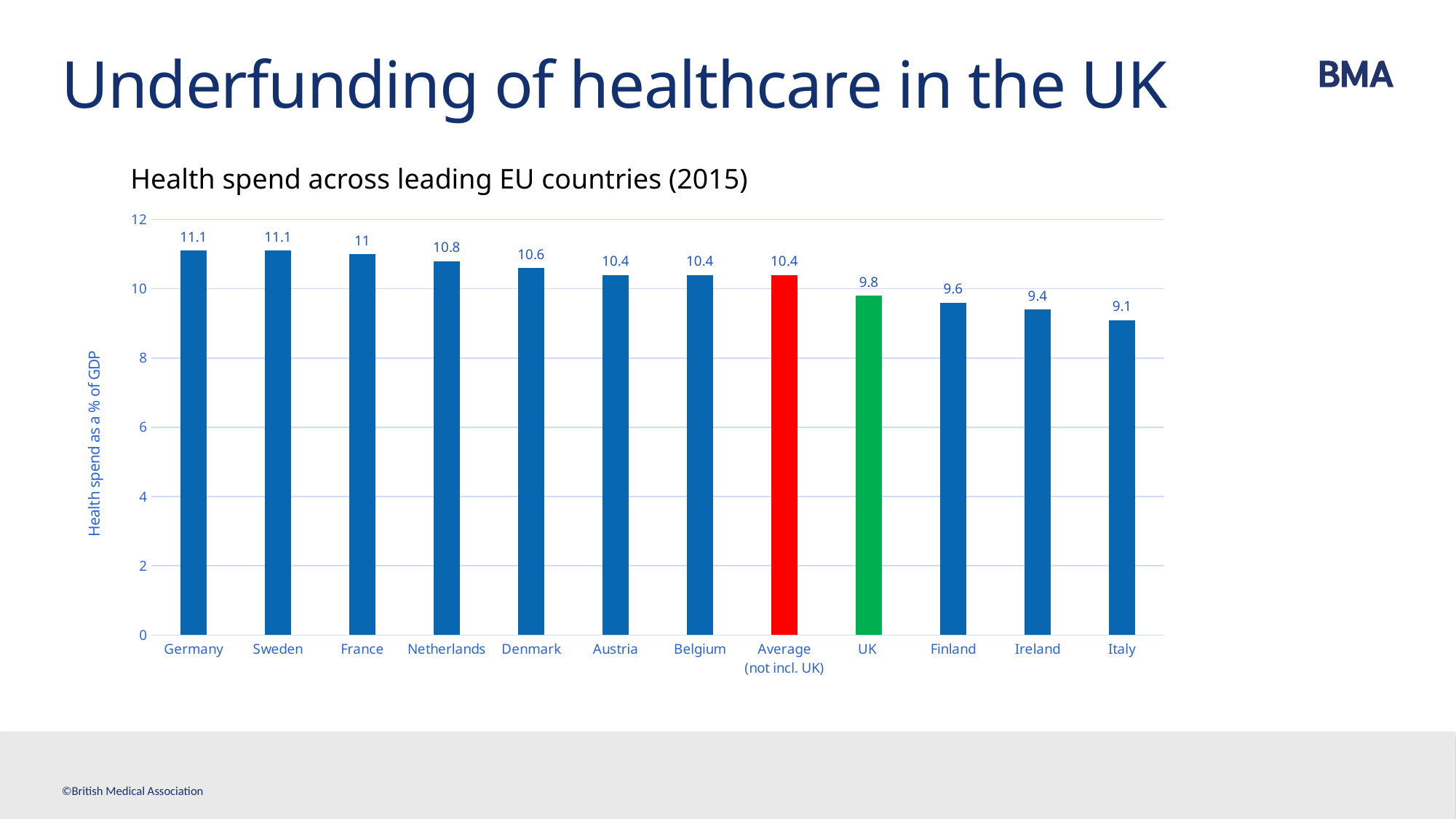
Which has a higher health spend as a % of GDP, France or Finland? France How many bars are shown in the chart? 12 What is the value shown for the Netherlands? 10.8 What kind of chart is shown on the slide? Bar chart What is the difference between the Average (not incl. UK) value and the UK value? 0.6 What colour is the UK bar? Green What is the difference between Germany's value and Italy's value? 2 What is the value shown for Average (not incl. UK)? 10.4 Do the values rise or fall from left to right across the chart? Fall Which country has the lowest health spend as a % of GDP? Italy Is the value for Ireland greater or less than 10? less What is the health spend as a % of GDP for the UK? 9.8